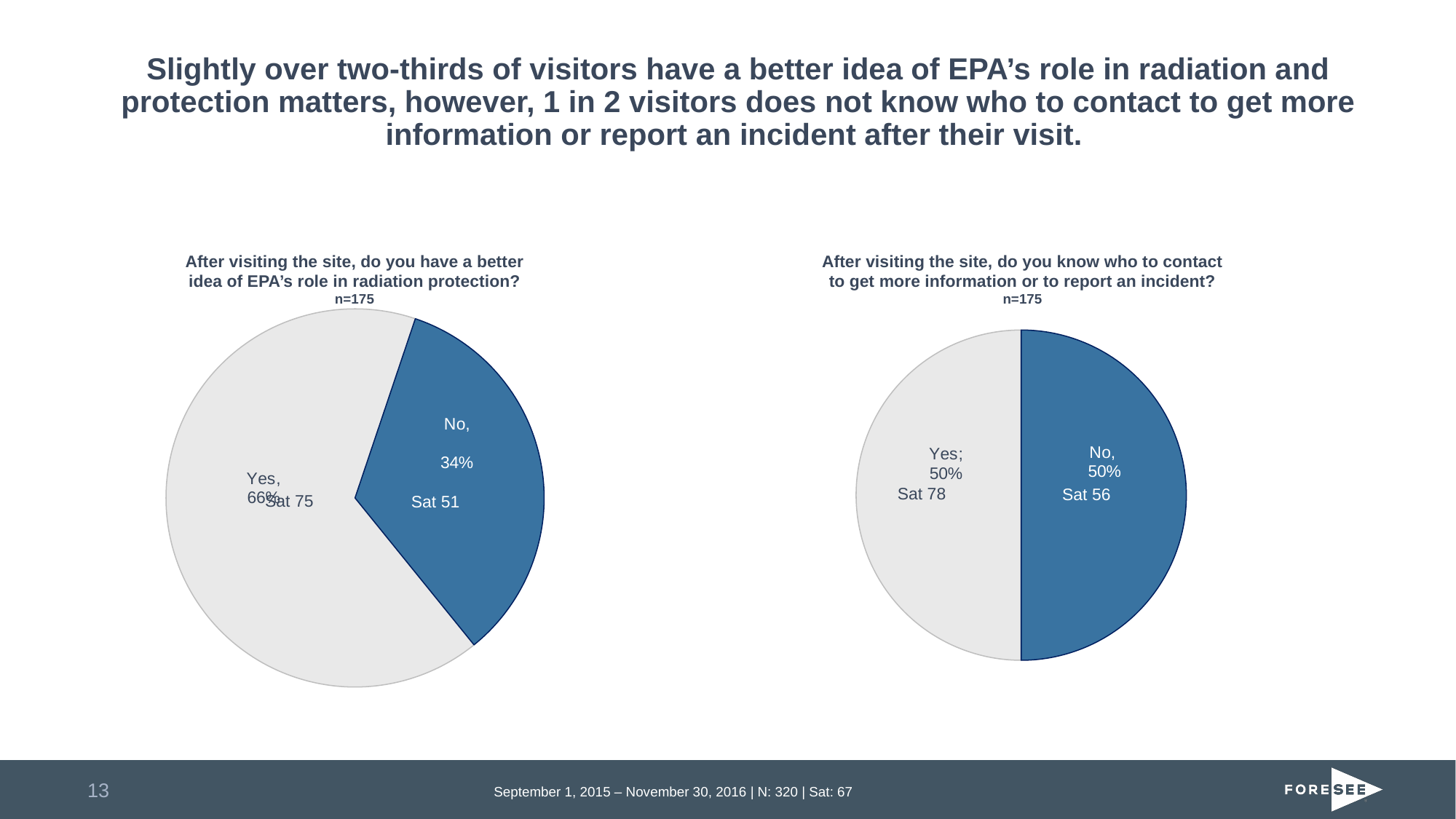
In the left pie chart (better idea of EPA's role in radiation protection), what is the satisfaction score shown for the No slice? 51 In the left pie chart (better idea of EPA's role in radiation protection), which response has the smaller share? No What type of chart is used on this slide? Pie chart In the left pie chart (better idea of EPA's role in radiation protection), which response has the larger share? Yes In the left pie chart (better idea of EPA's role in radiation protection), what percentage of visitors answered No? 34% How many slices does the right pie chart (know who to contact) have? 2 What sample size (n) is shown for the left pie chart (better idea of EPA's role in radiation protection)? 175 In the right pie chart (know who to contact), what percentage of visitors answered No? 50% In the left pie chart (better idea of EPA's role in radiation protection), what percentage of visitors answered Yes? 66% In the right pie chart (know who to contact), what is the satisfaction score shown for the No slice? 56 In the right pie chart (know who to contact), what is the satisfaction score shown for the Yes slice? 78 In the left pie chart (better idea of EPA's role in radiation protection), what is the difference in percentage points between the Yes and No shares? 32